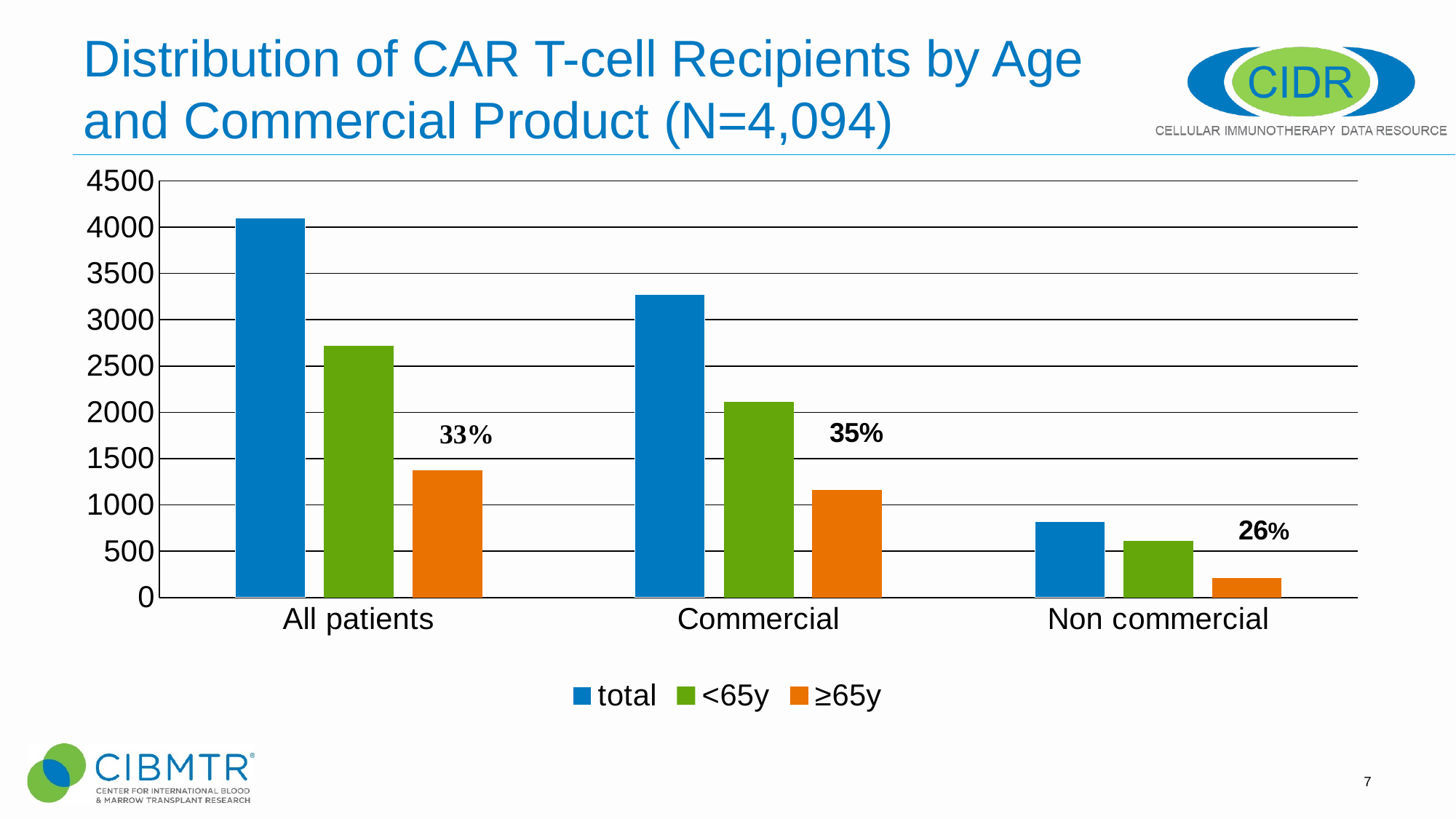
How many series does the legend list? 3 What kind of chart is shown on the slide? bar chart Which category has the highest total bar? All patients What percentage label is shown above the ≥65y bar for Non commercial? 26% Which is larger, the <65y bar for Commercial or the <65y bar for Non commercial? Commercial Which category has the lowest ≥65y bar? Non commercial How many categories are shown on the x axis? 3 Do the total bars rise or fall from left to right across the categories? fall What percentage label is shown above the ≥65y bar for All patients? 33% Is the total value for Commercial greater or less than 3000? greater Is the total value for Non commercial greater or less than 1000? less What percentage label is shown above the ≥65y bar for Commercial? 35%